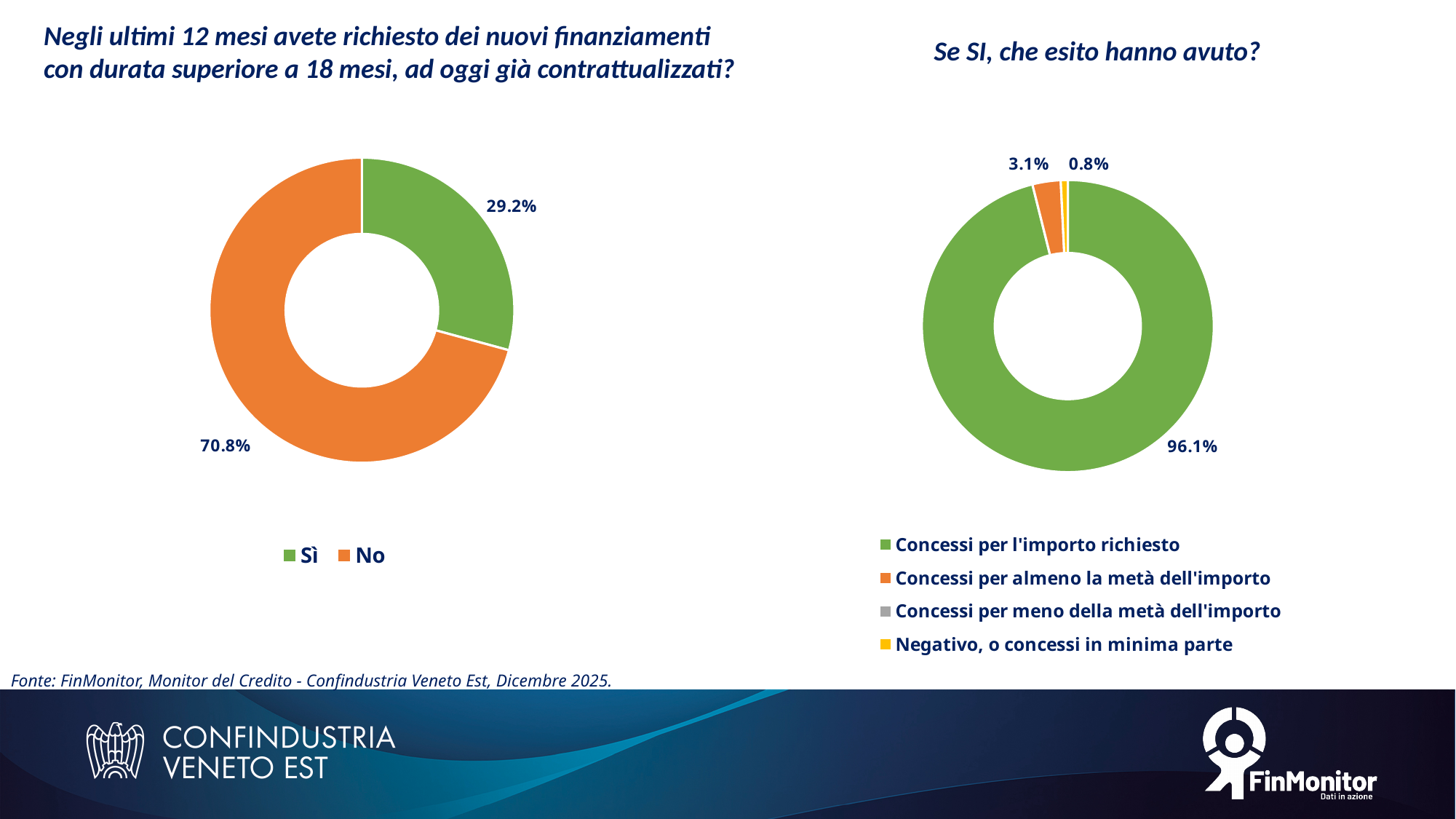
On the left chart, what is the difference in percentage points between 'No' and 'Sì'? 41.6 On the left chart, what percentage of respondents answered 'Sì'? 29.2% On the right chart ('Se SI, che esito hanno avuto?'), what percentage corresponds to 'Concessi per l'importo richiesto'? 96.1% On the right chart ('Se SI, che esito hanno avuto?'), what is the difference in percentage points between 'Concessi per almeno la metà dell'importo' and 'Negativo, o concessi in minima parte'? 2.3 What type of chart is used on the left side of the slide? Donut (pie) chart On the right chart ('Se SI, che esito hanno avuto?'), what percentage corresponds to 'Negativo, o concessi in minima parte'? 0.8% On the left chart, which answer has the larger share, 'Sì' or 'No'? No On the right chart ('Se SI, che esito hanno avuto?'), which category has the largest share? Concessi per l'importo richiesto On the left chart, what percentage of respondents answered 'No'? 70.8% On the right chart ('Se SI, che esito hanno avuto?'), how many categories does the legend list? 4 On the left chart, which colour represents the 'No' answer? Orange On the right chart ('Se SI, che esito hanno avuto?'), what percentage corresponds to 'Concessi per almeno la metà dell'importo'? 3.1%